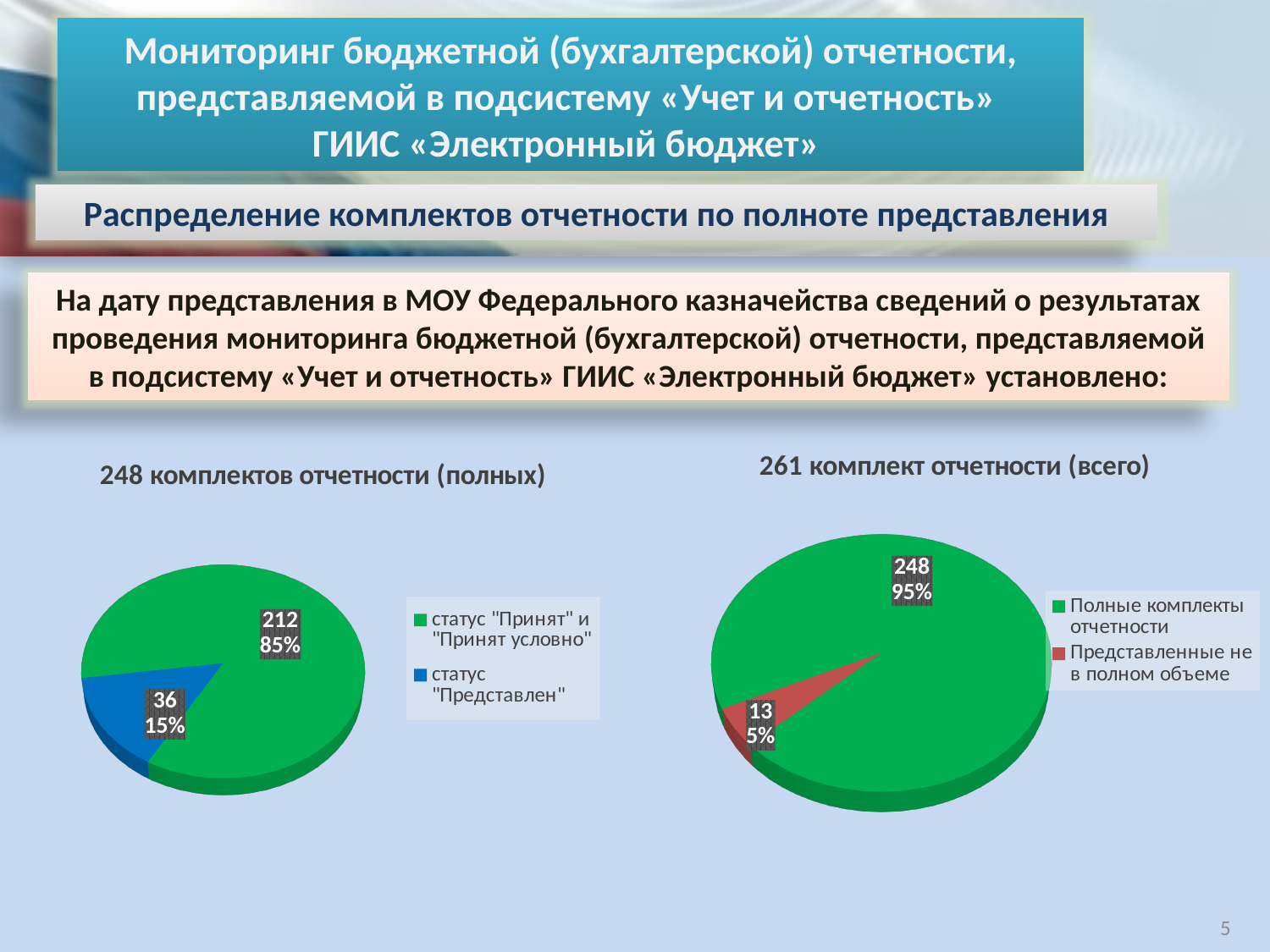
In the left chart titled "248 комплектов отчетности (полных)", what is the value for статус "Принят" и "Принят условно"? 212 In the left chart titled "248 комплектов отчетности (полных)", how many slices does the pie have? 2 In the left chart titled "248 комплектов отчетности (полных)", which category is the largest? статус "Принят" и "Принят условно" In the left chart titled "248 комплектов отчетности (полных)", what is the difference between the two slice values? 176 What kind of chart is the right chart titled "261 комплект отчетности (всего)"? Pie chart In the right chart titled "261 комплект отчетности (всего)", what is the value for Полные комплекты отчетности? 248 In the left chart titled "248 комплектов отчетности (полных)", what share of the pie does статус "Представлен" take? 15% In the right chart titled "261 комплект отчетности (всего)", what is the value for Представленные не в полном объеме? 13 In the left chart titled "248 комплектов отчетности (полных)", what is the value for статус "Представлен"? 36 In the right chart titled "261 комплект отчетности (всего)", what colour is the slice for Представленные не в полном объеме? Red In the right chart titled "261 комплект отчетности (всего)", which category is the smallest? Представленные не в полном объеме In the right chart titled "261 комплект отчетности (всего)", what share of the pie does Полные комплекты отчетности take? 95%